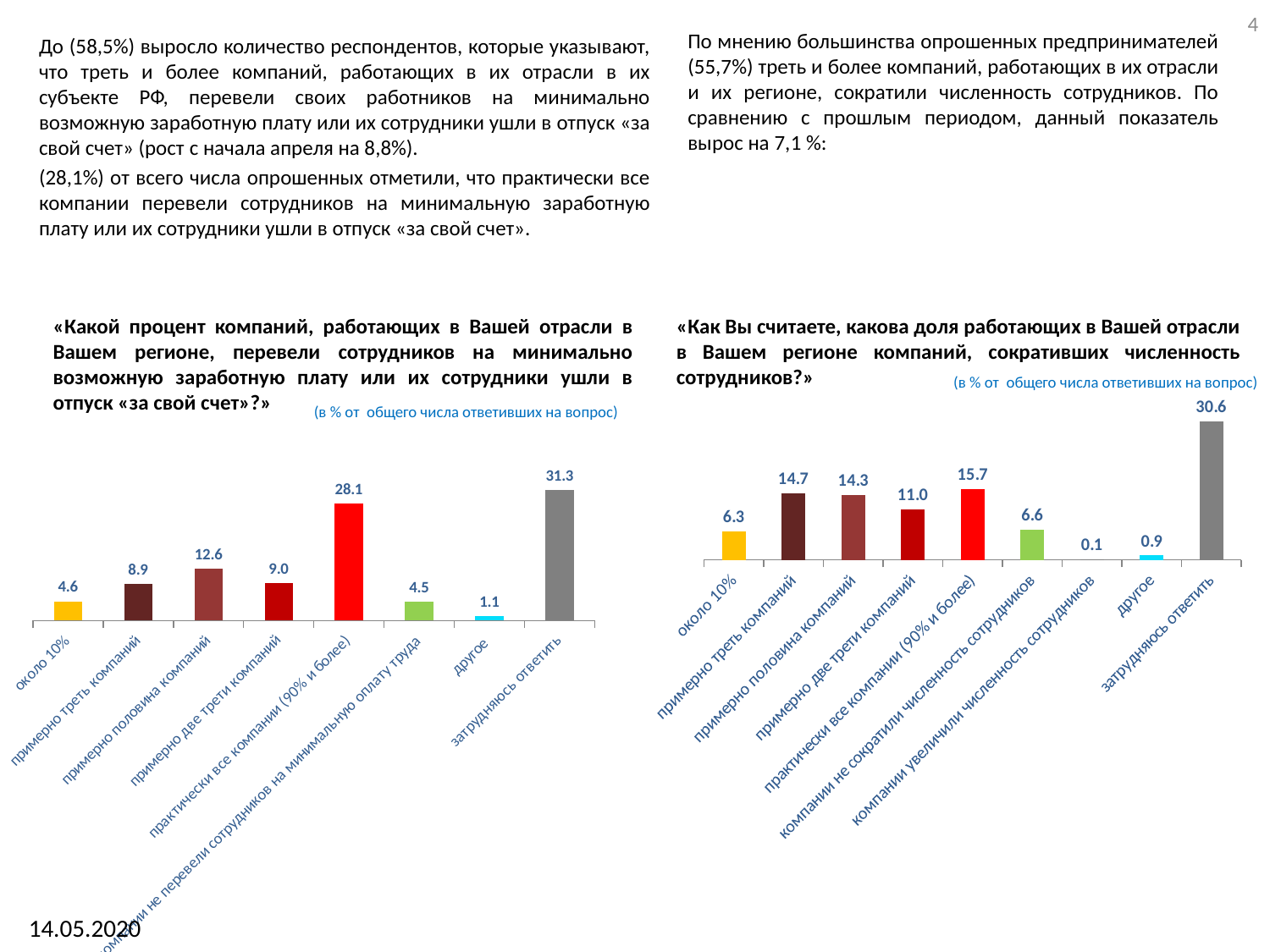
In the right chart, what is the difference between «затрудняюсь ответить» and «около 10%»? 24.3 In the right chart, what is the value for «примерно треть компаний»? 14.7 In the left chart, which category has the highest value? затрудняюсь ответить In the left chart, which category has the lowest value? другое In the right chart, which is larger: «примерно две трети компаний» or «практически все компании (90% и более)»? практически все компании (90% и более) In the left chart, what is the value for «практически все компании (90% и более)»? 28.1 In the left chart, how many categories are shown? 8 In the right chart, which category has the lowest value? компании увеличили численность сотрудников What type of chart is the left chart? bar chart In the right chart, which category has the highest value? затрудняюсь ответить In the right chart, how many categories are shown? 9 In the left chart, what is the difference between «затрудняюсь ответить» and «практически все компании (90% и более)»? 3.2